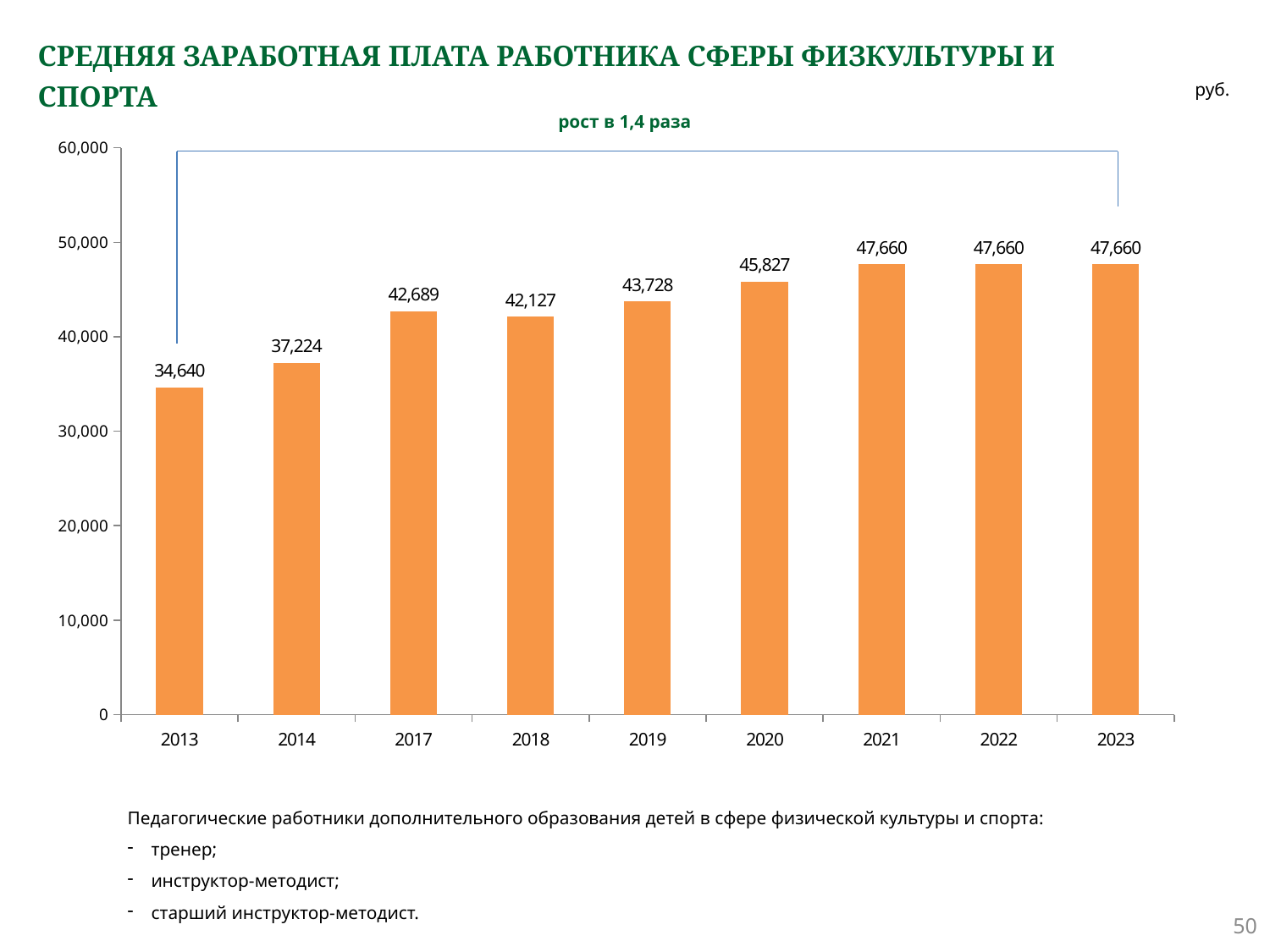
What is the difference between the values for 2014 and 2013? 2,584 How many years are shown on the x axis? 9 Which is larger, the value for 2017 or the value for 2018? 2017 What is the average salary value shown for 2013? 34,640 Is the value for 2021 greater or less than 40,000? greater Which year has the lowest value on the chart? 2013 What is the highest value shown on the chart? 47,660 What type of chart is shown on the slide? bar chart What is the difference between the values for 2023 and 2013? 13,020 What is the value shown for 2019? 43,728 What growth factor is stated in the annotation above the chart? рост в 1,4 раза What is the value shown for 2020? 45,827